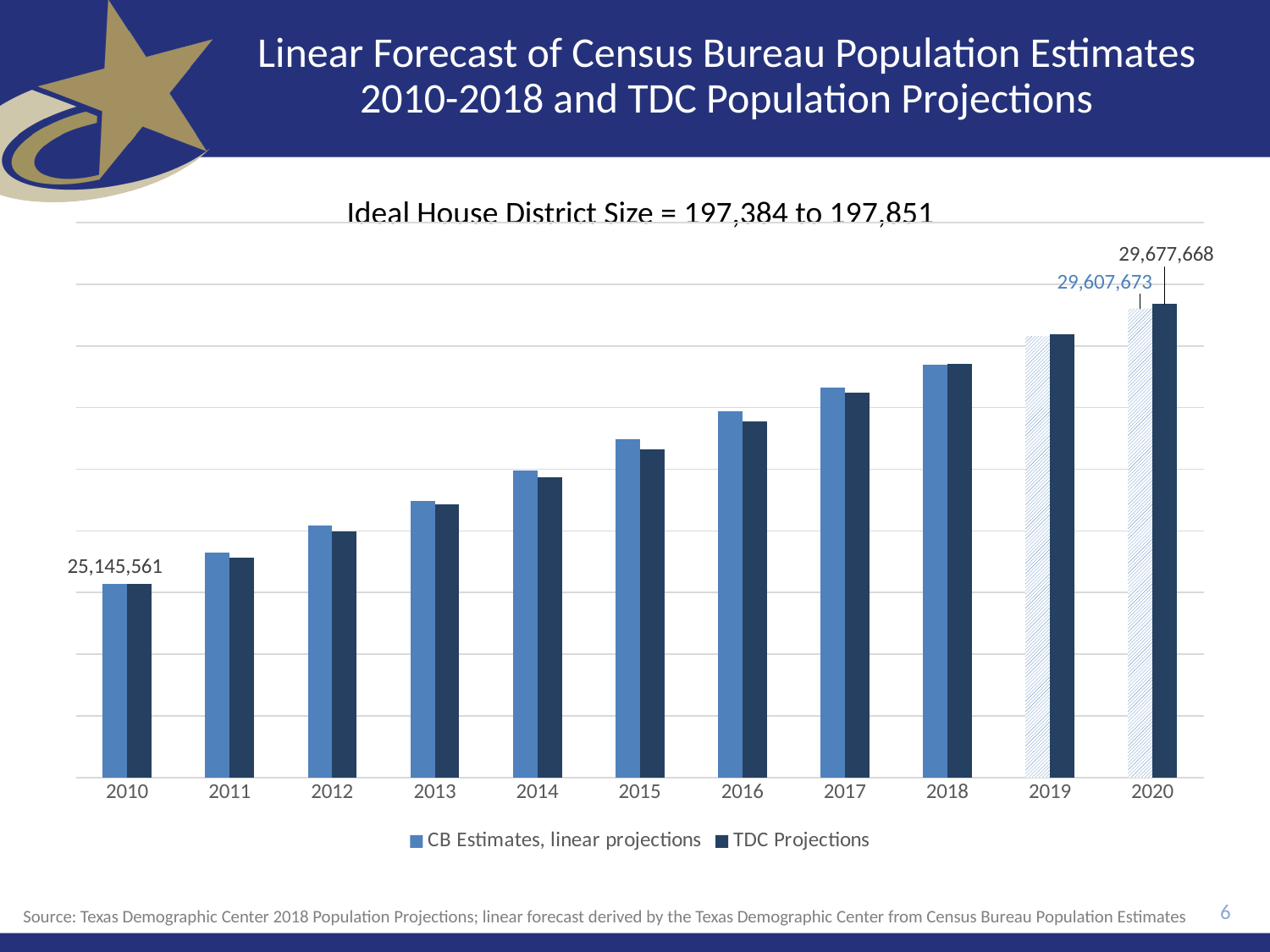
For 2020, which series has the larger value, CB Estimates, linear projections or TDC Projections? TDC Projections What kind of chart is shown on the slide? bar chart What is the difference between the TDC Projections value and the CB Estimates value for 2020? 69,995 What is the TDC Projections value for 2020? 29,677,668 Which year has the highest TDC Projections value? 2020 How many years are shown along the x axis? 11 Do the values rise or fall from 2010 to 2020? rise For 2015, which series has the larger value, CB Estimates, linear projections or TDC Projections? CB Estimates, linear projections What is the CB Estimates, linear projections value for 2020? 29,607,673 What value is labeled on the chart for 2010? 25,145,561 What is the title shown above the chart? Ideal House District Size = 197,384 to 197,851 How many series does the legend list? 2